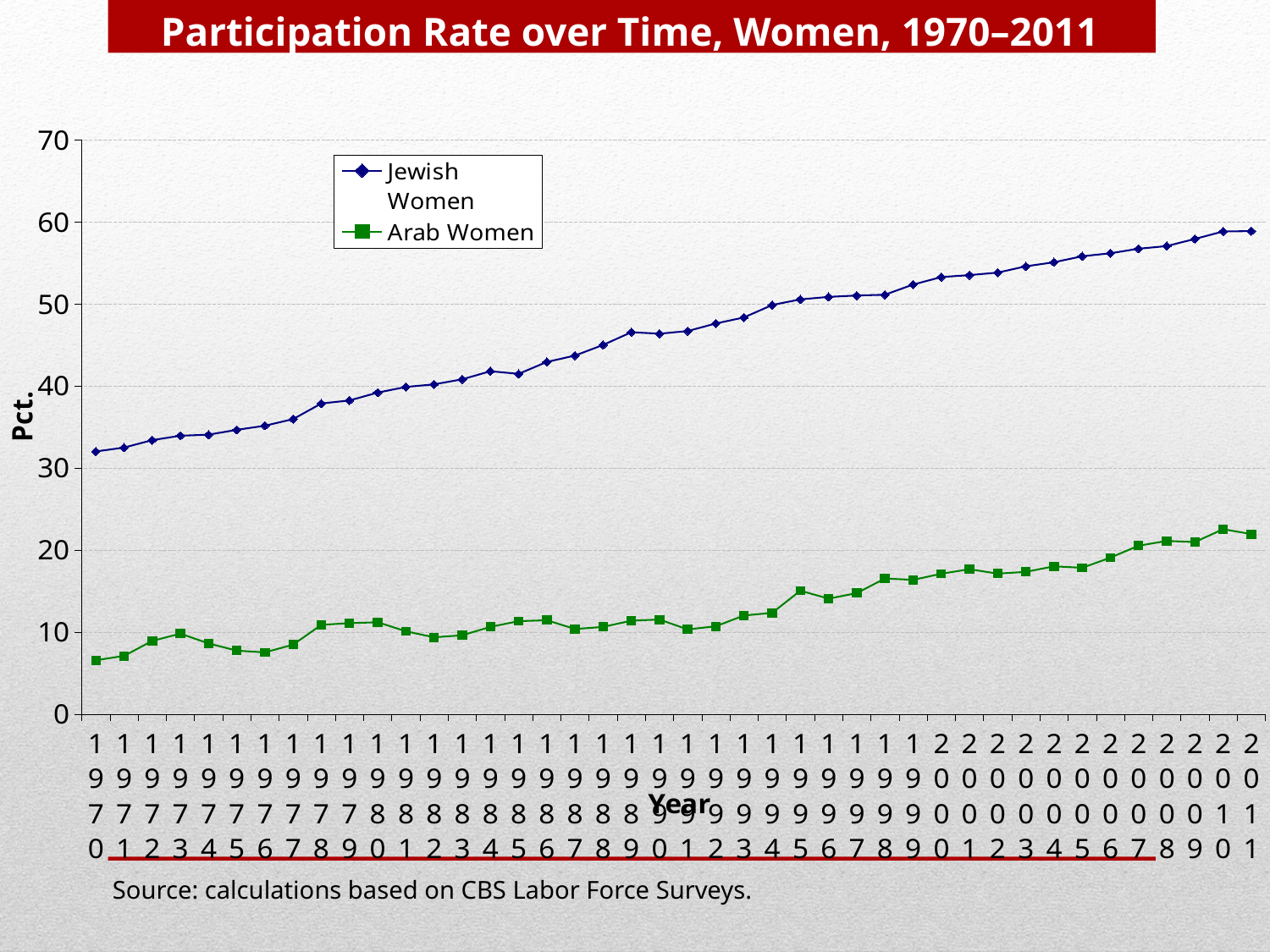
Is the participation rate for Arab Women in 1970 greater or less than 10? less Is the participation rate for Jewish Women in 2011 greater or less than 60? less What kind of chart is shown on the slide? line chart How many series does the legend list? 2 Is the participation rate for Jewish Women in 1990 greater or less than 40? greater Which series has the higher participation rate in 2000, Jewish Women or Arab Women? Jewish Women What is the label on the y axis of the chart? Pct. In which year is the participation rate for Jewish Women lowest? 1970 How many years are plotted along the x axis? 42 Do the participation rates for Jewish Women generally rise or fall from 1970 to 2011? rise